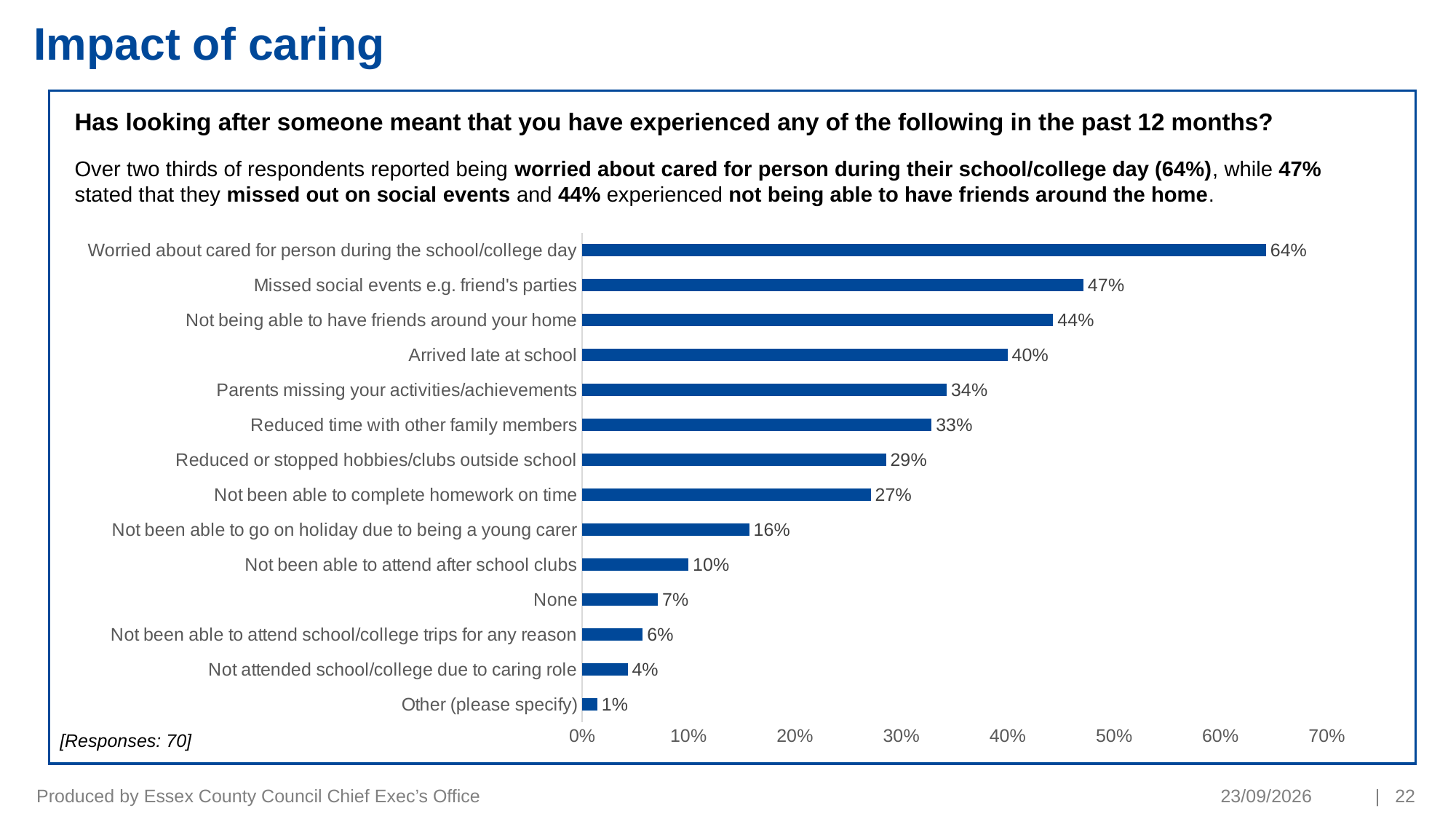
Which category has the lowest value? Other (please specify) How many responses does the chart note as its base? 70 Which category has the highest value? Worried about cared for person during the school/college day What is the value for 'Arrived late at school'? 40% What is the difference between 'Not been able to complete homework on time' and 'Not been able to go on holiday due to being a young carer'? 11% Which is larger: 'Reduced time with other family members' or 'Reduced or stopped hobbies/clubs outside school'? Reduced time with other family members How many categories are shown in the chart? 14 What kind of chart is shown on the slide? Bar chart What percentage of respondents reported being worried about the cared for person during the school/college day? 64% What is the value for 'Not been able to attend after school clubs'? 10% What percentage of respondents selected 'None'? 7% What is the difference between 'Missed social events e.g. friend's parties' and 'Not being able to have friends around your home'? 3%